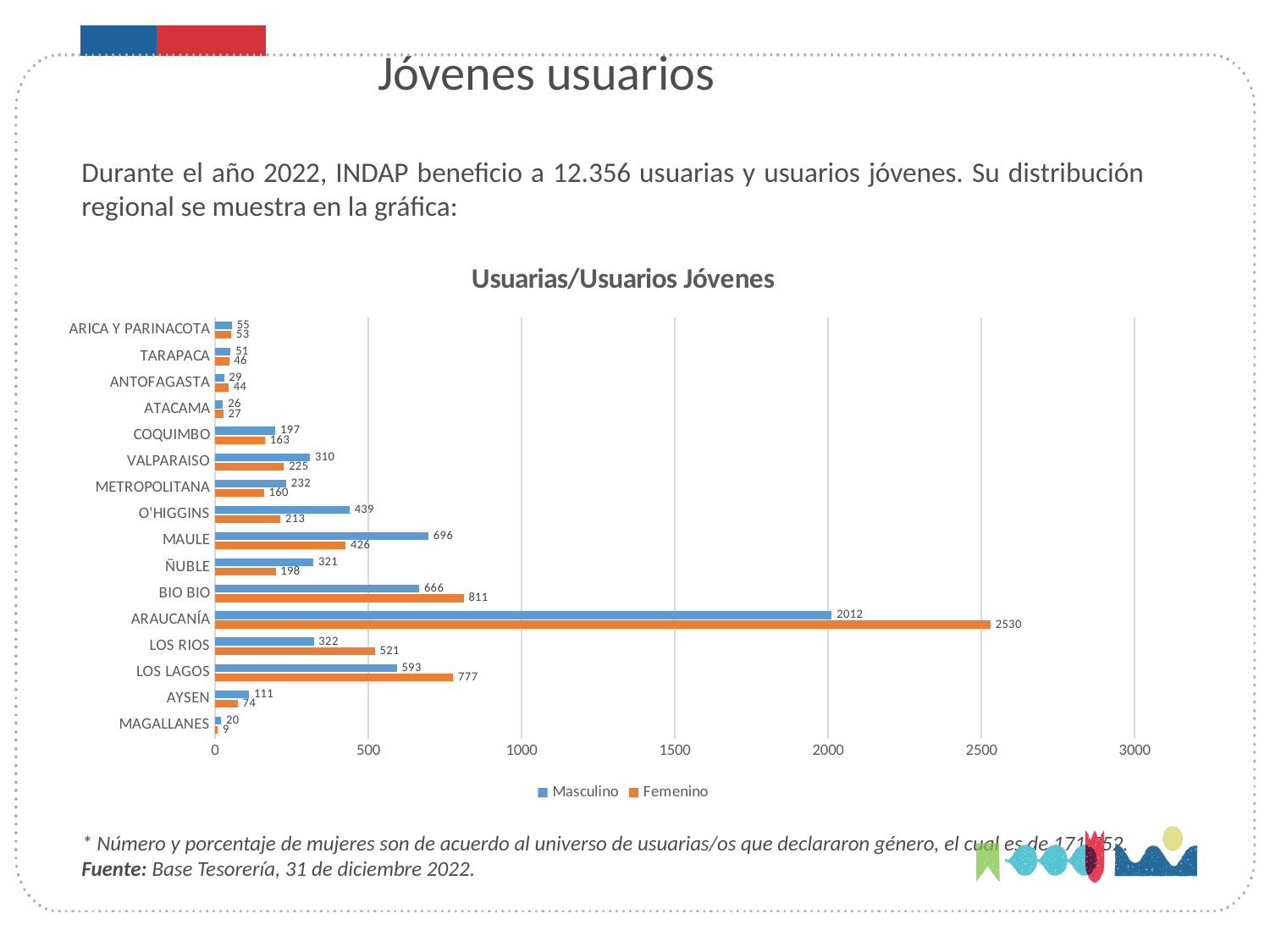
What is the difference between the Femenino and Masculino values for ARAUCANÍA? 518 Is the Masculino value for O'HIGGINS greater or less than 500? less What is the Femenino value for BIO BIO? 811 What is the Femenino value for LOS LAGOS? 777 What is the title of the chart? Usuarias/Usuarios Jóvenes What kind of chart is shown on the slide? bar chart What is the Masculino value for ARAUCANÍA? 2012 How many series does the legend list? 2 Which region has the highest Femenino value? ARAUCANÍA Which is larger for MAULE, the Masculino value or the Femenino value? Masculino How many regions are shown on the chart? 16 Which region has the lowest Masculino value? MAGALLANES